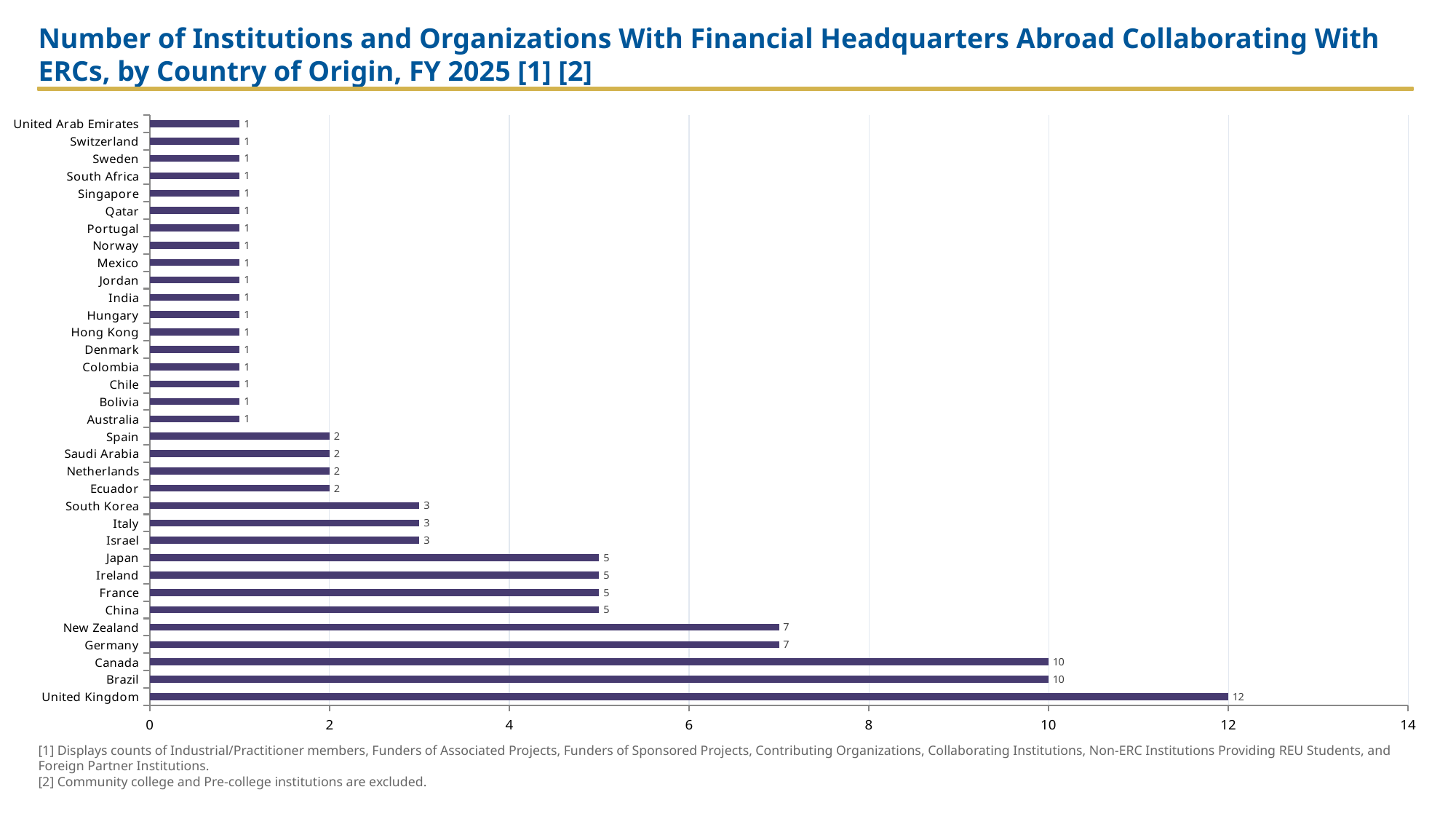
How many countries are shown in the chart? 34 What is the difference between the values for the United Kingdom and Canada? 2 Which is larger, the value for Israel or the value for France? France What is the value for Japan? 5 Which country has the highest value? United Kingdom Which is larger, the value for Brazil or the value for Germany? Brazil What kind of chart is shown on the slide? Bar chart What is the value for Germany? 7 What is the highest value shown on the horizontal axis? 14 What is the difference between the values for New Zealand and Italy? 4 What is the value for Netherlands? 2 What is the value for the United Kingdom? 12